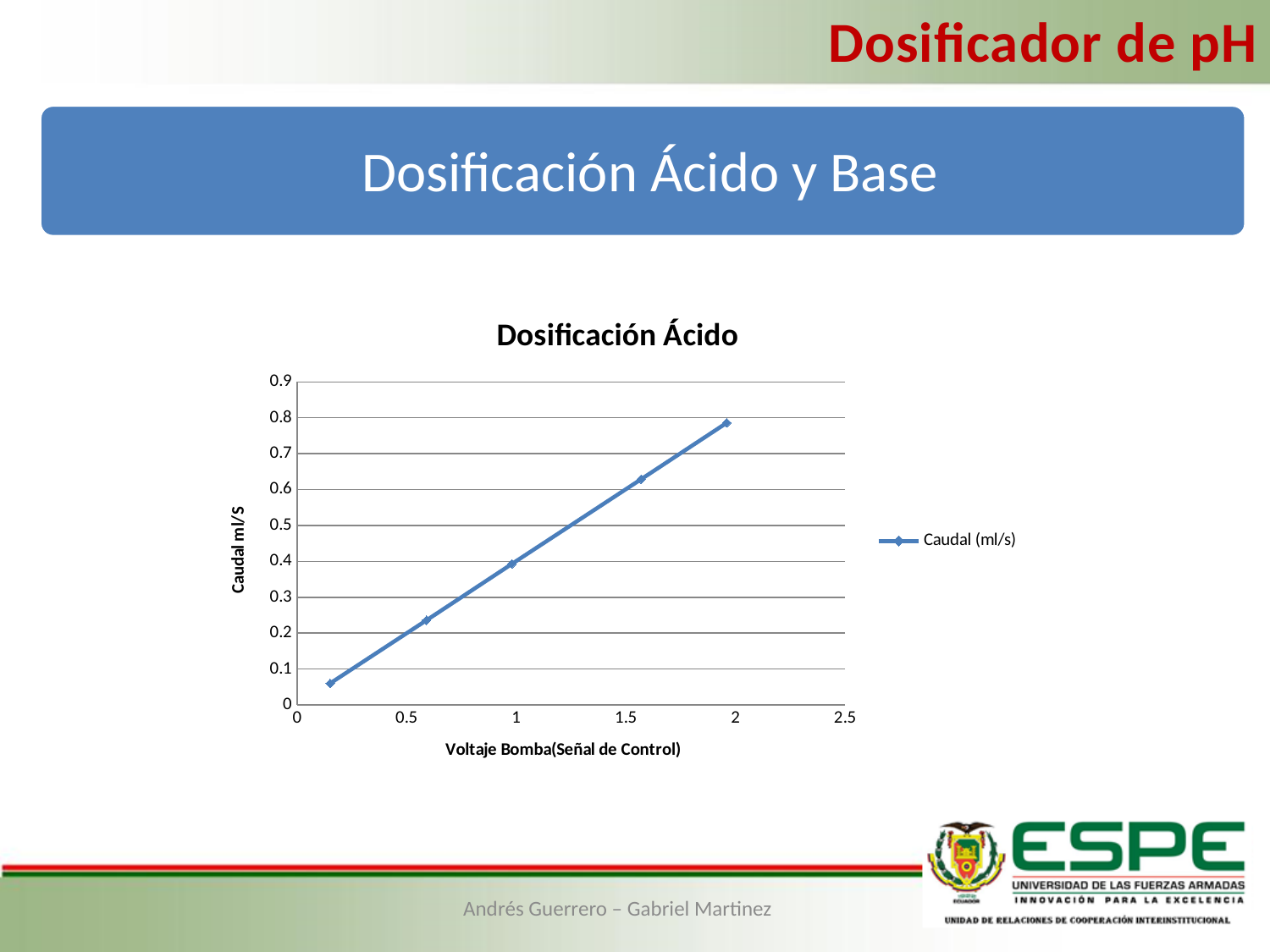
What is the title of the chart? Dosificación Ácido Is the value of the leftmost data point greater or less than 0.1? less Do the values rise or fall as the voltage increases along the x axis? rise What is the name of the series shown in the legend? Caudal (ml/s) Is the value of the data point near a voltage of 1 greater or less than 0.5? less Is the value of the rightmost data point greater or less than 0.7? greater How many data points are plotted on the line? 5 What kind of chart is shown on the slide? line chart How many series does the legend list? 1 Which data point has the lowest Caudal value, the leftmost or the rightmost? leftmost Which data point has the highest Caudal value, the leftmost or the rightmost? rightmost